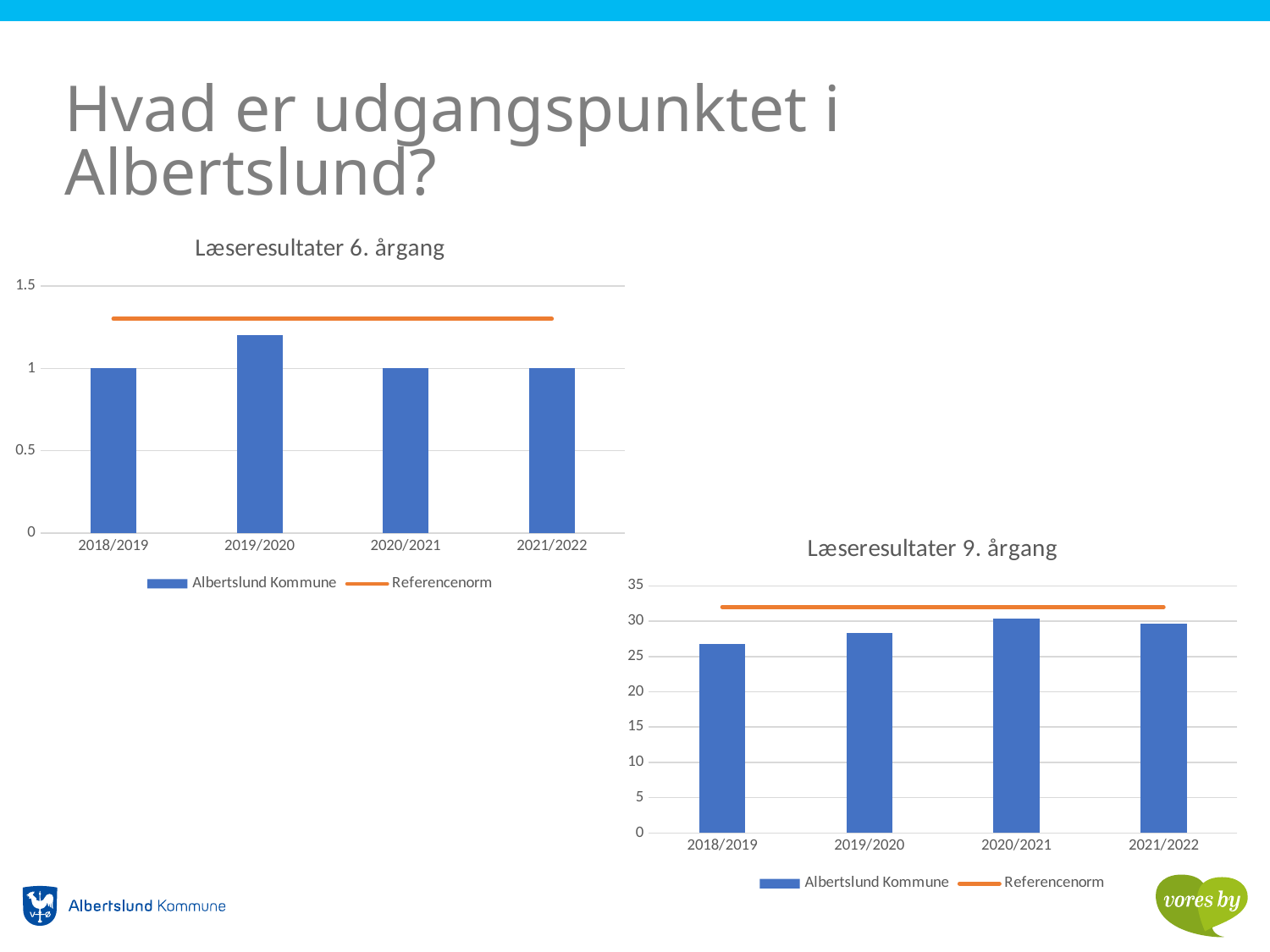
In the chart titled "Læseresultater 6. årgang", is the Albertslund Kommune value for 2019/2020 greater or less than 1? greater In the chart titled "Læseresultater 6. årgang", what is the Albertslund Kommune value for 2018/2019? 1 In the chart titled "Læseresultater 9. årgang", which school year has the lowest Albertslund Kommune bar? 2018/2019 In the chart titled "Læseresultater 6. årgang", how many school years are shown on the x axis? 4 In the chart titled "Læseresultater 9. årgang", what are the two entries listed in the legend? Albertslund Kommune and Referencenorm In the chart titled "Læseresultater 9. årgang", which is larger, the Albertslund Kommune value for 2018/2019 or for 2019/2020? 2019/2020 In the chart titled "Læseresultater 6. årgang", how many series does the legend list? 2 In the chart titled "Læseresultater 9. årgang", which school year has the highest Albertslund Kommune bar? 2020/2021 In the chart titled "Læseresultater 9. årgang", is the Albertslund Kommune value for 2018/2019 greater or less than 30? less In the chart titled "Læseresultater 6. årgang", what kind of chart is used to show the Albertslund Kommune values? Bar chart In the chart titled "Læseresultater 6. årgang", which school year has the highest Albertslund Kommune bar? 2019/2020